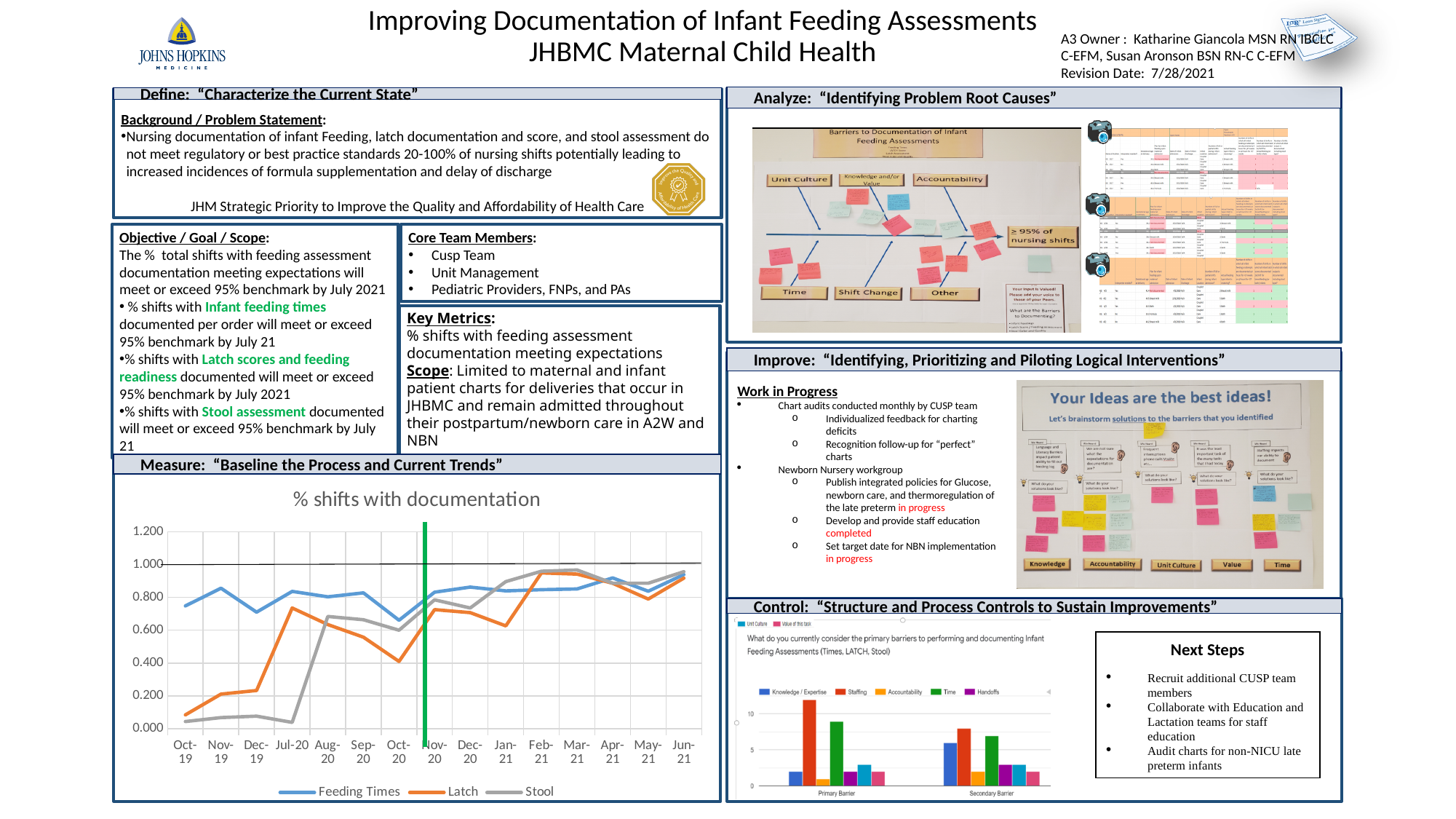
In the '% shifts with documentation' chart, is the Feeding Times value for Nov-19 greater or less than 0.800? greater What kind of chart is shown in the Measure section? line chart In the '% shifts with documentation' chart, is the Stool value for Jul-20 greater or less than 0.200? less In the '% shifts with documentation' chart, is the Latch value for Oct-19 greater or less than 0.200? less In the '% shifts with documentation' chart, at which time point is the Latch series at its lowest? Oct-19 In the '% shifts with documentation' chart, which is larger at Oct-19: Feeding Times or Latch? Feeding Times In the '% shifts with documentation' chart, does the Latch series overall rise or fall from Oct-19 to Jun-21? rise What is the title of the chart in the Measure section? % shifts with documentation How many time points are plotted along the x axis of the '% shifts with documentation' chart? 15 In the '% shifts with documentation' chart, which is larger at Jul-20: Latch or Stool? Latch How many series does the legend of the '% shifts with documentation' chart list? 3